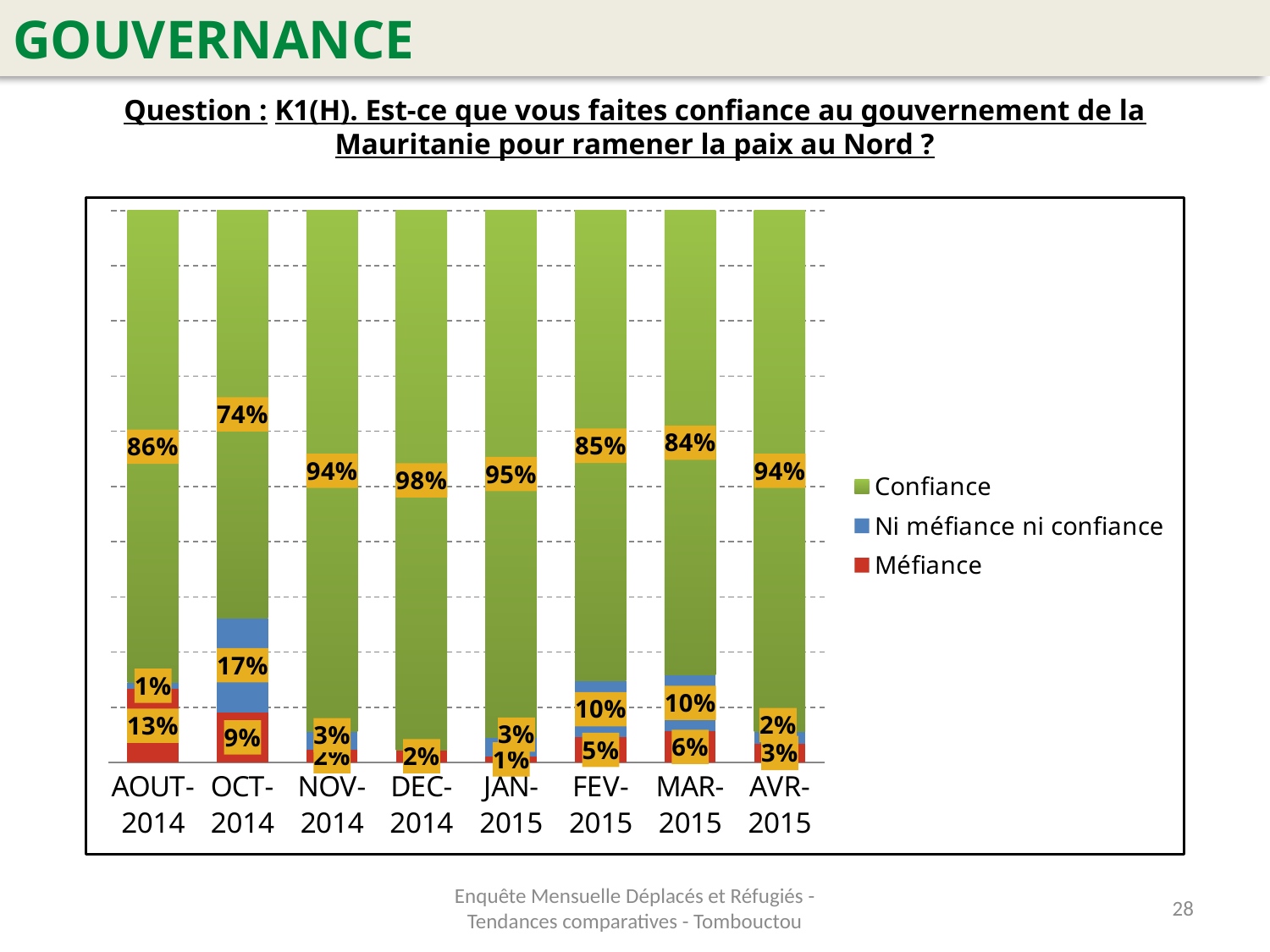
What is the Méfiance value for AOUT-2014? 13% How many series does the legend list? 3 How many months (categories) are shown on the x axis? 8 What is the Confiance value for FEV-2015? 85% In which month is the Confiance value lowest? OCT-2014 In which month is the Confiance value highest? DEC-2014 What is the Ni méfiance ni confiance value for OCT-2014? 17% What is the Confiance value for OCT-2014? 74% Which legend entry is shown in red? Méfiance What is the difference between the Confiance values for DEC-2014 and OCT-2014? 24% Which is larger, the Méfiance value for MAR-2015 or for FEV-2015? MAR-2015 What kind of chart is shown on the slide? Stacked bar chart